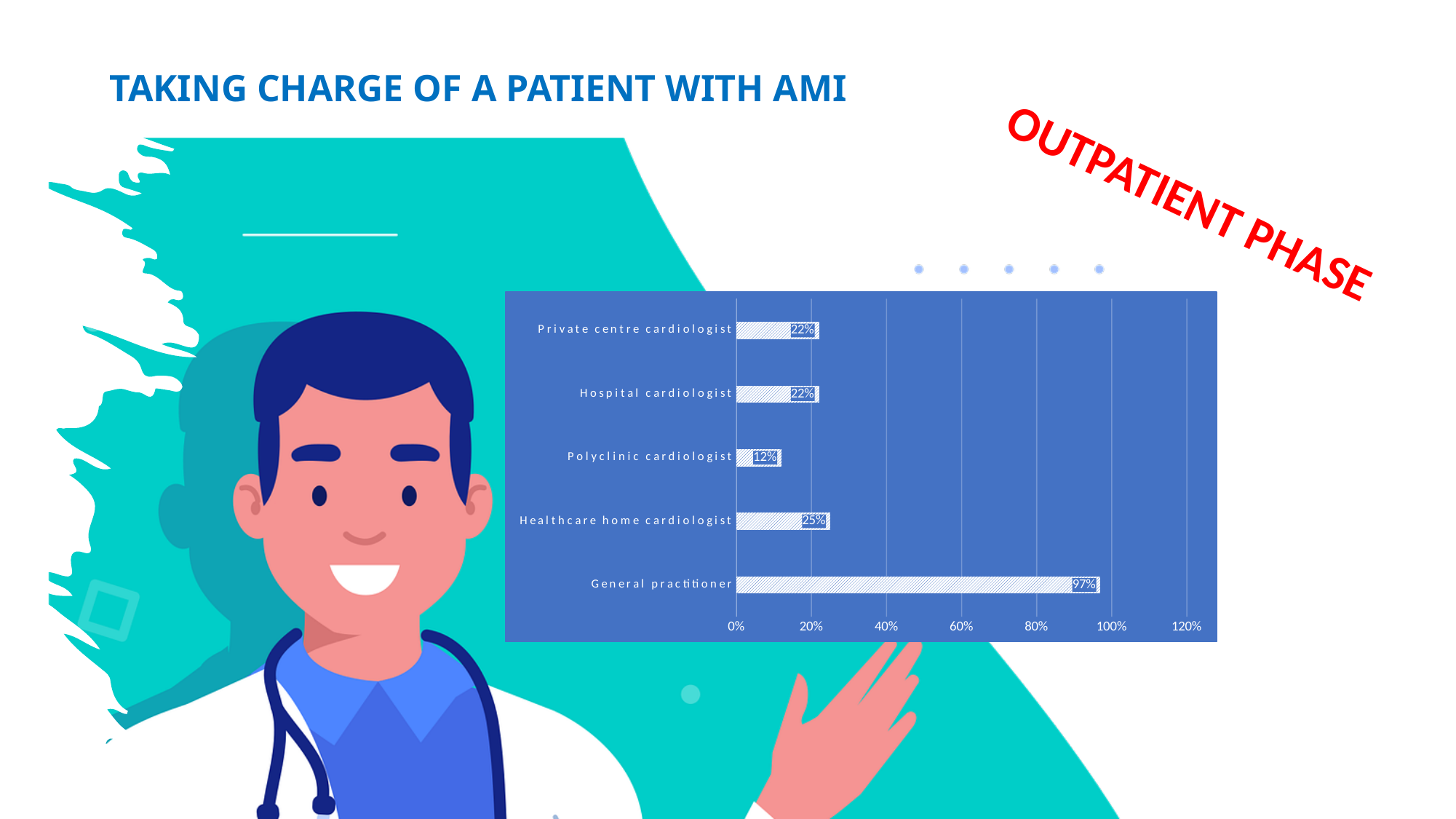
Which category has the highest value? General practitioner What is the value for Healthcare home cardiologist? 25% Which category has the lowest value? Polyclinic cardiologist What kind of chart is shown on the slide? bar chart What is the difference between the values for Healthcare home cardiologist and Polyclinic cardiologist? 13% What is the difference between the values for General practitioner and Healthcare home cardiologist? 72% What is the value for General practitioner? 97% How many categories are shown in the chart? 5 Is the value for General practitioner greater or less than 80%? greater What is the value for Hospital cardiologist? 22% What is the value for Polyclinic cardiologist? 12% Which is larger, the value for Healthcare home cardiologist or the value for Private centre cardiologist? Healthcare home cardiologist